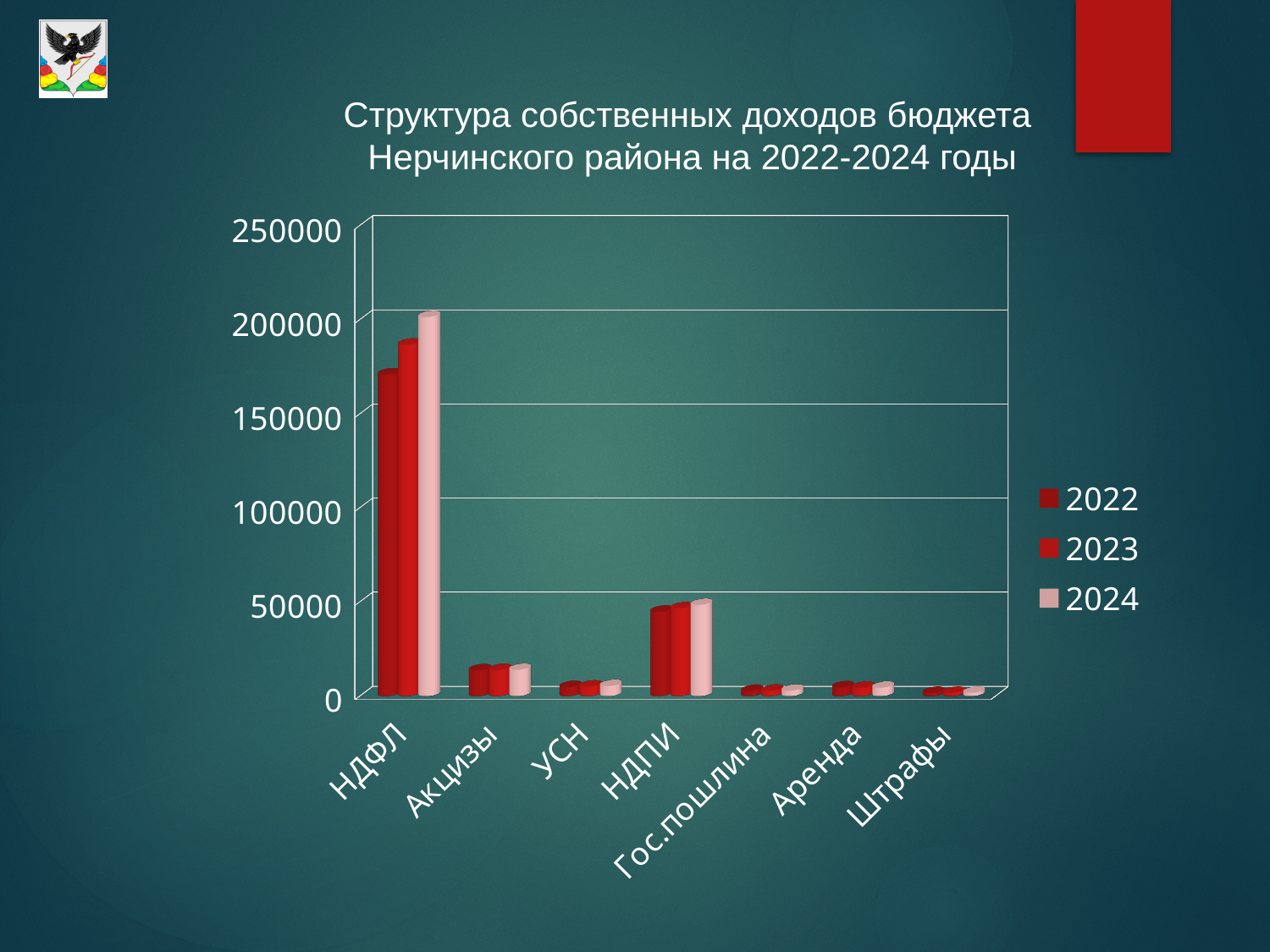
Is the value for Акцизы in 2023 greater or less than 50000? less Is the value for НДФЛ in 2022 greater or less than 150000? greater Is the value for НДФЛ in 2024 greater or less than 150000? greater Which years are listed in the chart's legend? 2022, 2023, 2024 Which category has the highest values in the chart? НДФЛ How many series does the chart's legend list? 3 Which is larger in 2024, the value for НДФЛ or the value for НДПИ? НДФЛ Which is larger in 2022, the value for Акцизы or the value for УСН? Акцизы What kind of chart is shown on the slide? bar chart Do the values for НДФЛ rise or fall from 2022 to 2024? rise How many categories are shown on the x axis of the chart? 7